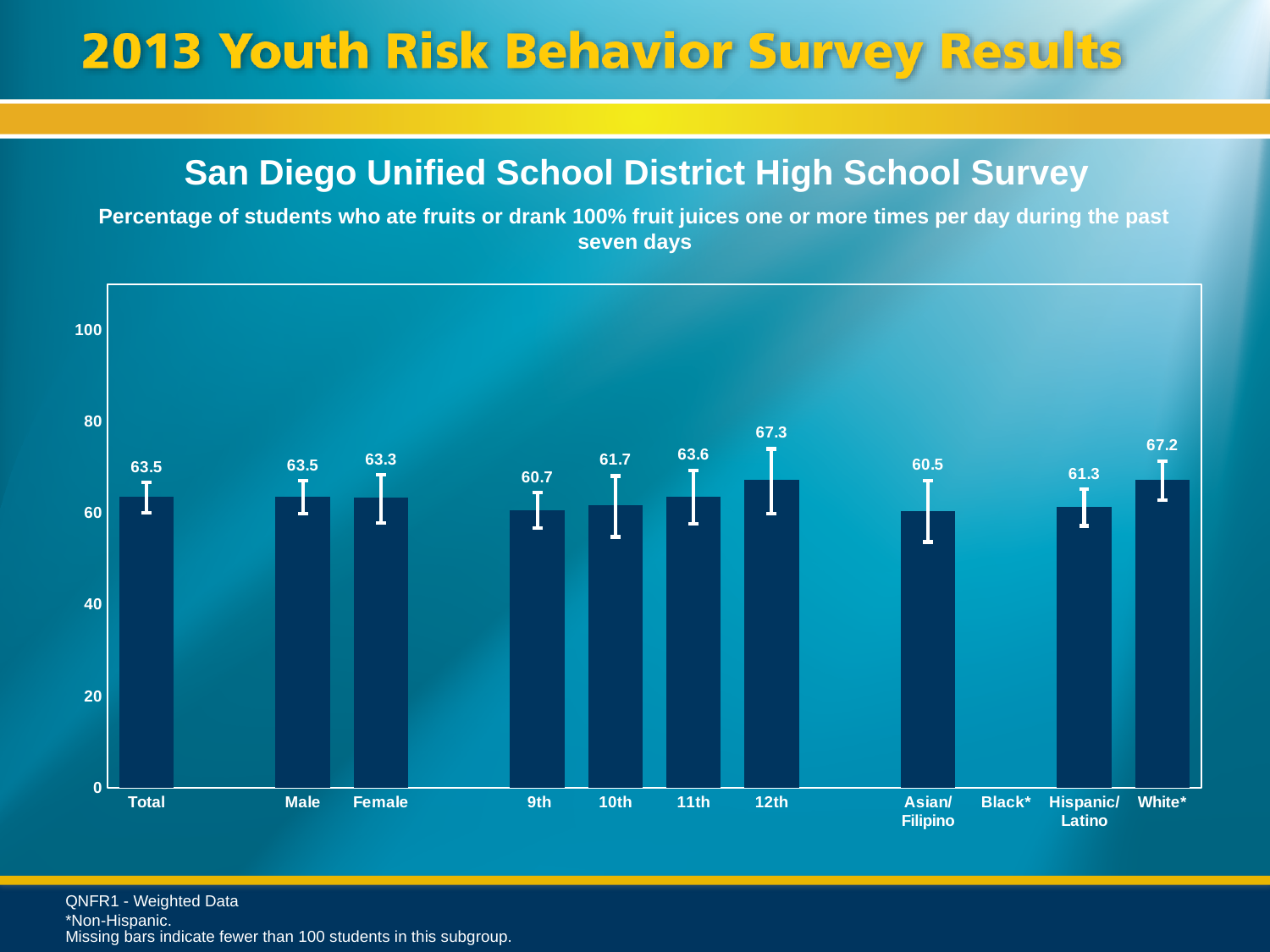
Which category has the lowest plotted value? Asian/Filipino What is the value for Hispanic/Latino? 61.3 Is the value for Female greater or less than 60? greater What is the difference between the values for 12th and 9th grade? 6.6 What kind of chart is shown? bar chart How many bars are plotted on the chart? 10 What is the value for Total? 63.5 Which category has the highest value? 12th What is the value for Asian/Filipino? 60.5 Which category has no bar shown? Black* Which is larger, the value for White* or the value for Hispanic/Latino? White* What is the value for 12th grade? 67.3